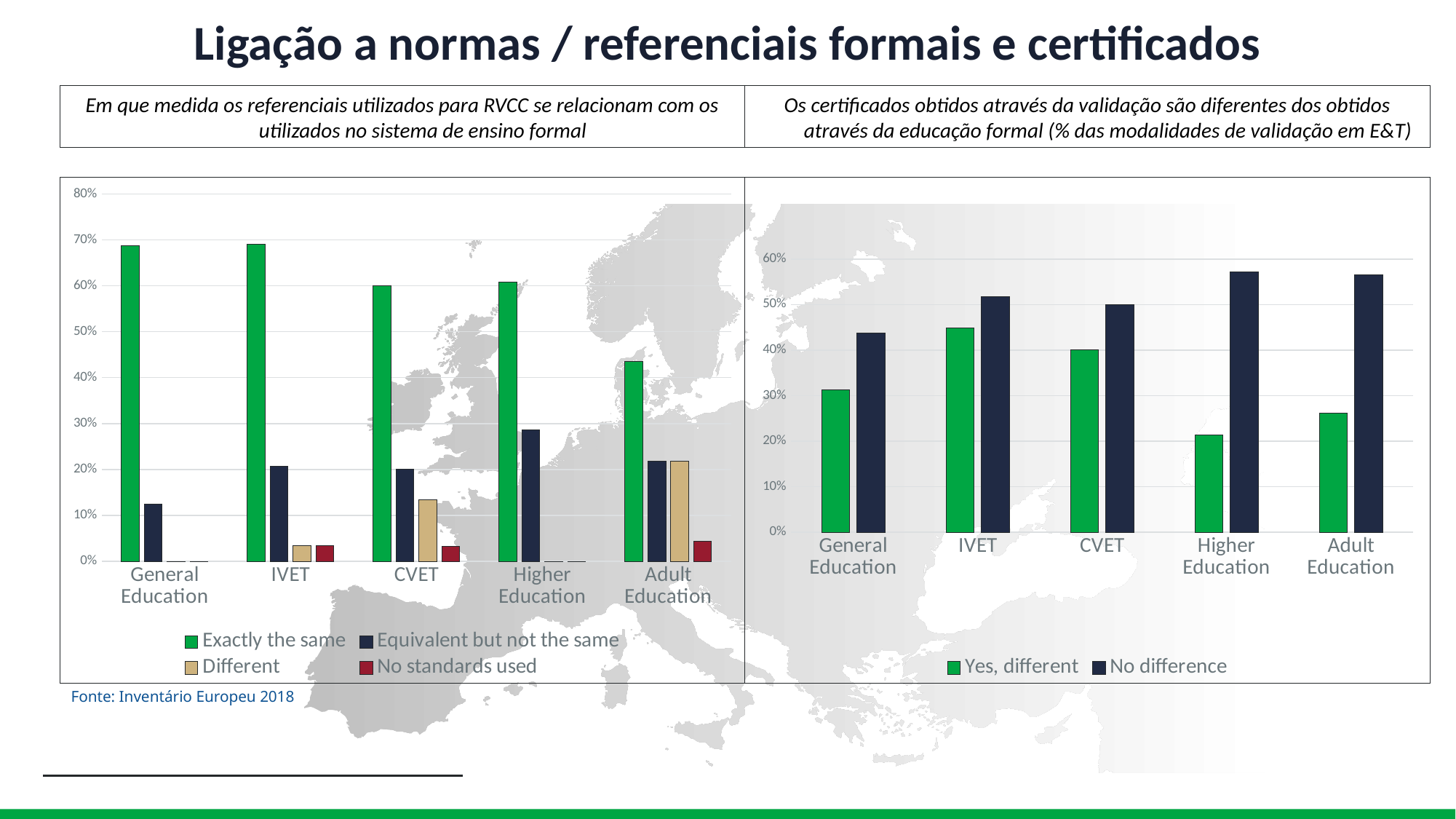
In the left chart, is the 'Exactly the same' value for Adult Education greater or less than 40%? greater In the right chart, is the 'Yes, different' value for Higher Education greater or less than 30%? less In the right chart, for General Education, which is larger: 'Yes, different' or 'No difference'? No difference In the right chart, which category has the highest value for 'Yes, different'? IVET How many categories are shown on the x axis of the right chart? 5 How many series does the legend of the right chart list? 2 In the left chart, which category has the highest value for 'Equivalent but not the same'? Higher Education In the left chart, for CVET, which is larger: 'Different' or 'No standards used'? Different What kind of chart is the left chart on the slide? bar chart In the right chart, which category has the lowest value for 'No difference'? General Education How many series does the legend of the left chart list? 4 In the left chart, which category has the lowest value for 'Exactly the same'? Adult Education